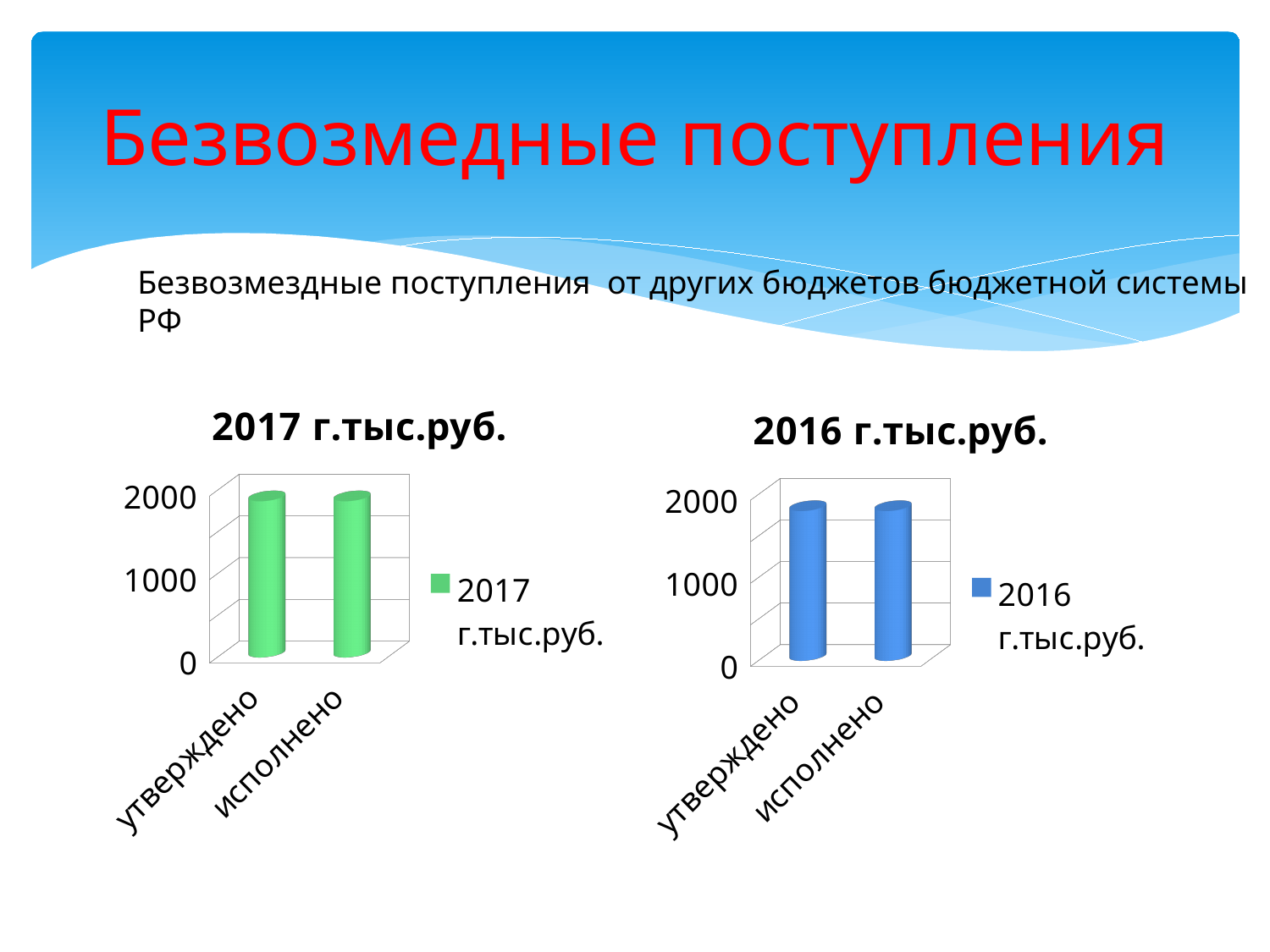
In the "2016 г.тыс.руб." chart, is the value for исполнено greater or less than 2000? less How many categories are shown on the x axis of the "2017 г.тыс.руб." chart? 2 What colour are the bars in the "2016 г.тыс.руб." chart? blue What is the title of the chart on the left side of the slide? 2017 г.тыс.руб. What type of chart is the "2016 г.тыс.руб." chart? bar chart How many series does the legend of the "2016 г.тыс.руб." chart list? 1 How many categories are shown on the x axis of the "2016 г.тыс.руб." chart? 2 In the "2016 г.тыс.руб." chart, is the value for утверждено greater or less than 1000? greater What type of chart is the "2017 г.тыс.руб." chart? bar chart How many series does the legend of the "2017 г.тыс.руб." chart list? 1 In the "2017 г.тыс.руб." chart, is the value for утверждено greater or less than 1000? greater